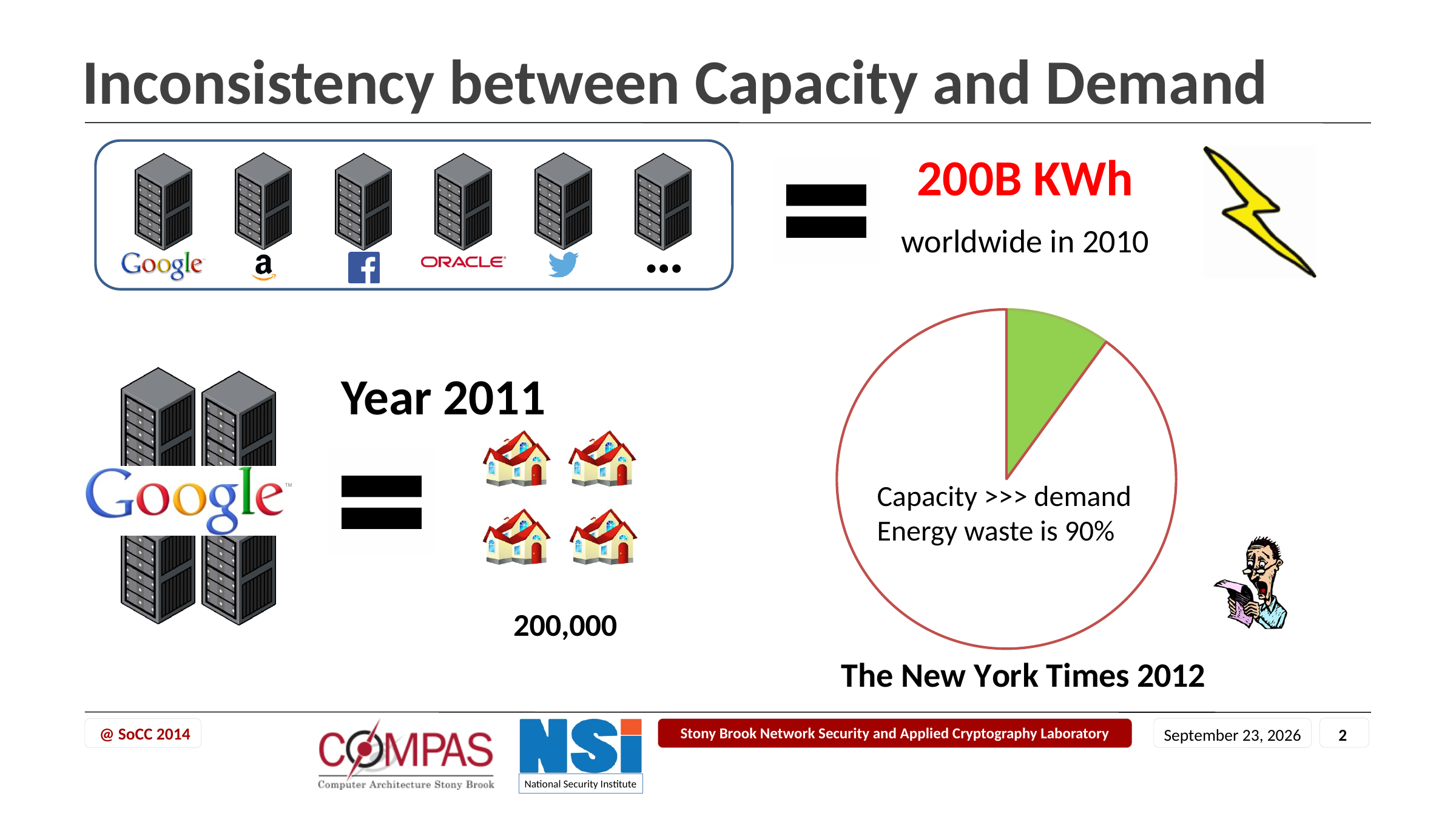
Which slice of the pie chart is larger, the green slice or the white slice? the white slice According to the text inside the pie chart, what percentage is the energy waste? 90% What source is cited below the pie chart? The New York Times 2012 What kind of chart is shown on the right side of the slide? pie chart What colour is the smaller slice of the pie chart? green Which slice of the pie chart is the smallest? the green slice Is the green slice of the pie chart greater or less than 50% of the pie? less How many slices does the pie chart have? 2